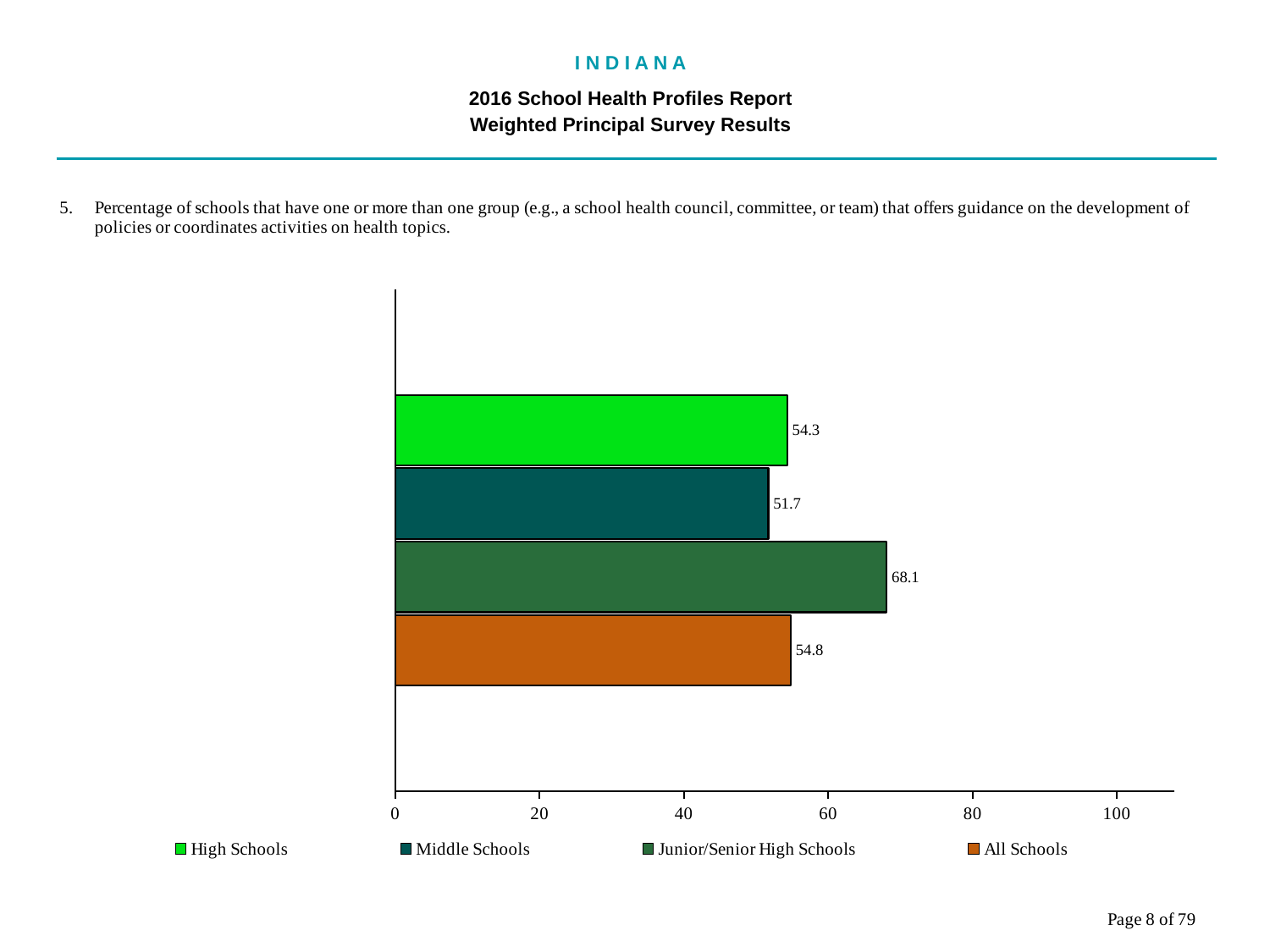
What is the value for All Schools? 54.8 What is the difference between the values for Junior/Senior High Schools and Middle Schools? 16.4 What is the value for Junior/Senior High Schools? 68.1 What is the difference between the values for All Schools and High Schools? 0.5 Which school type has the highest value? Junior/Senior High Schools What is the value for Middle Schools? 51.7 What is the value for High Schools? 54.3 Is the value for Middle Schools greater or less than 60? less Which school type has the lowest value? Middle Schools How many series does the legend list? 4 Which is larger, the value for Junior/Senior High Schools or the value for High Schools? Junior/Senior High Schools What kind of chart is shown on the slide? bar chart